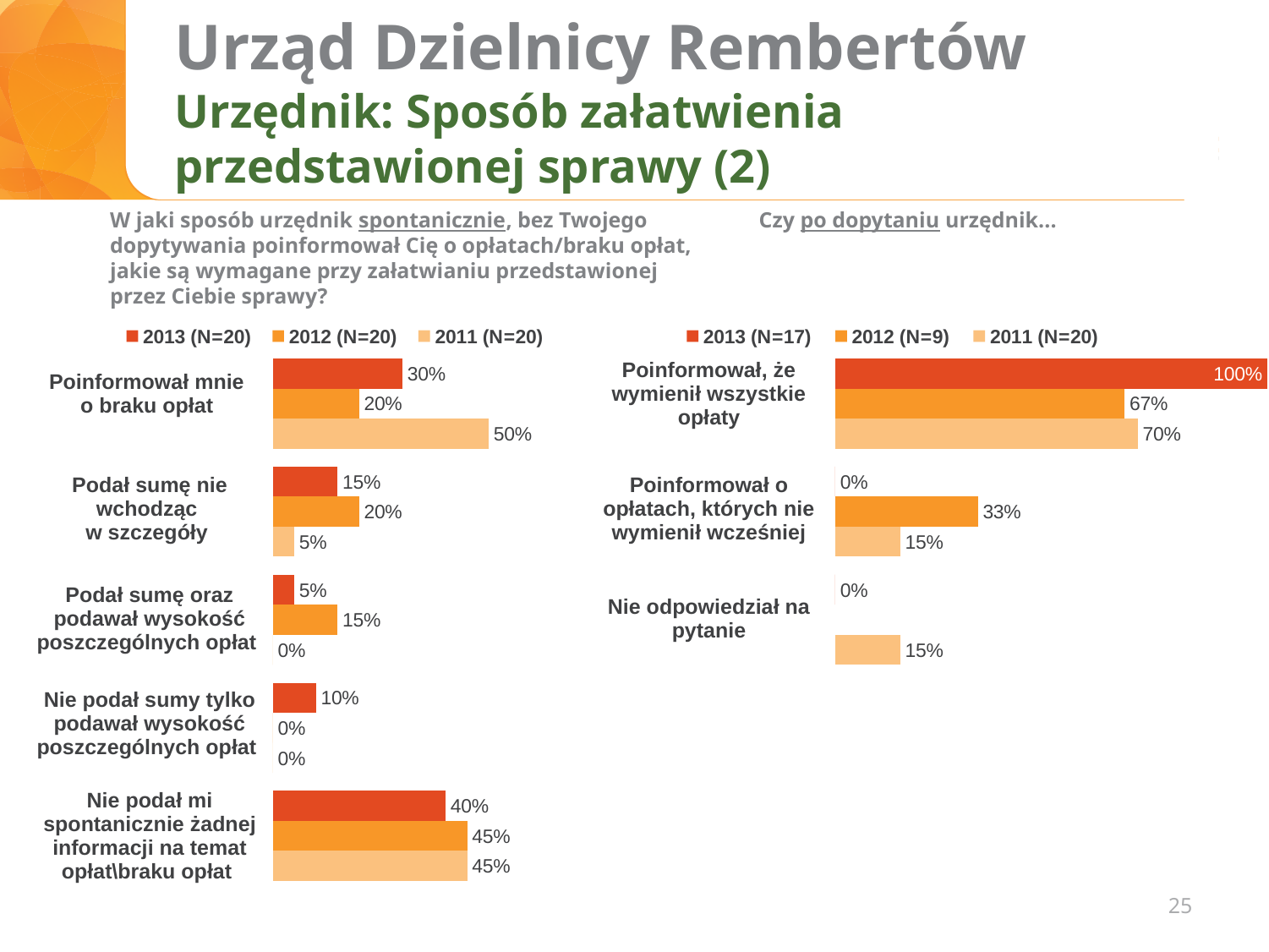
How many series does the legend of the right chart list? 3 In the left chart, what is the difference between the 2011 (N=20) and 2013 (N=20) values for 'Poinformował mnie o braku opłat'? 20% In the left chart, which category has the highest 2013 (N=20) value? Nie podał mi spontanicznie żadnej informacji na temat opłat\braku opłat In the left chart, which is larger for 'Podał sumę nie wchodząc w szczegóły': the 2012 (N=20) value or the 2011 (N=20) value? 2012 (N=20) In the left chart, what is the 2011 (N=20) value for 'Poinformował mnie o braku opłat'? 50% In the right chart, what is the 2013 (N=17) value for 'Poinformował, że wymienił wszystkie opłaty'? 100% In the left chart, what is the 2013 (N=20) value for 'Nie podał mi spontanicznie żadnej informacji na temat opłat\braku opłat'? 40% How many categories does the left chart show? 5 In the right chart, what is the 2012 (N=9) value for 'Poinformował o opłatach, których nie wymienił wcześniej'? 33% In the right chart, what is the difference between the 2013 (N=17) and 2012 (N=9) values for 'Poinformował, że wymienił wszystkie opłaty'? 33% What type of chart is the left chart? Bar chart